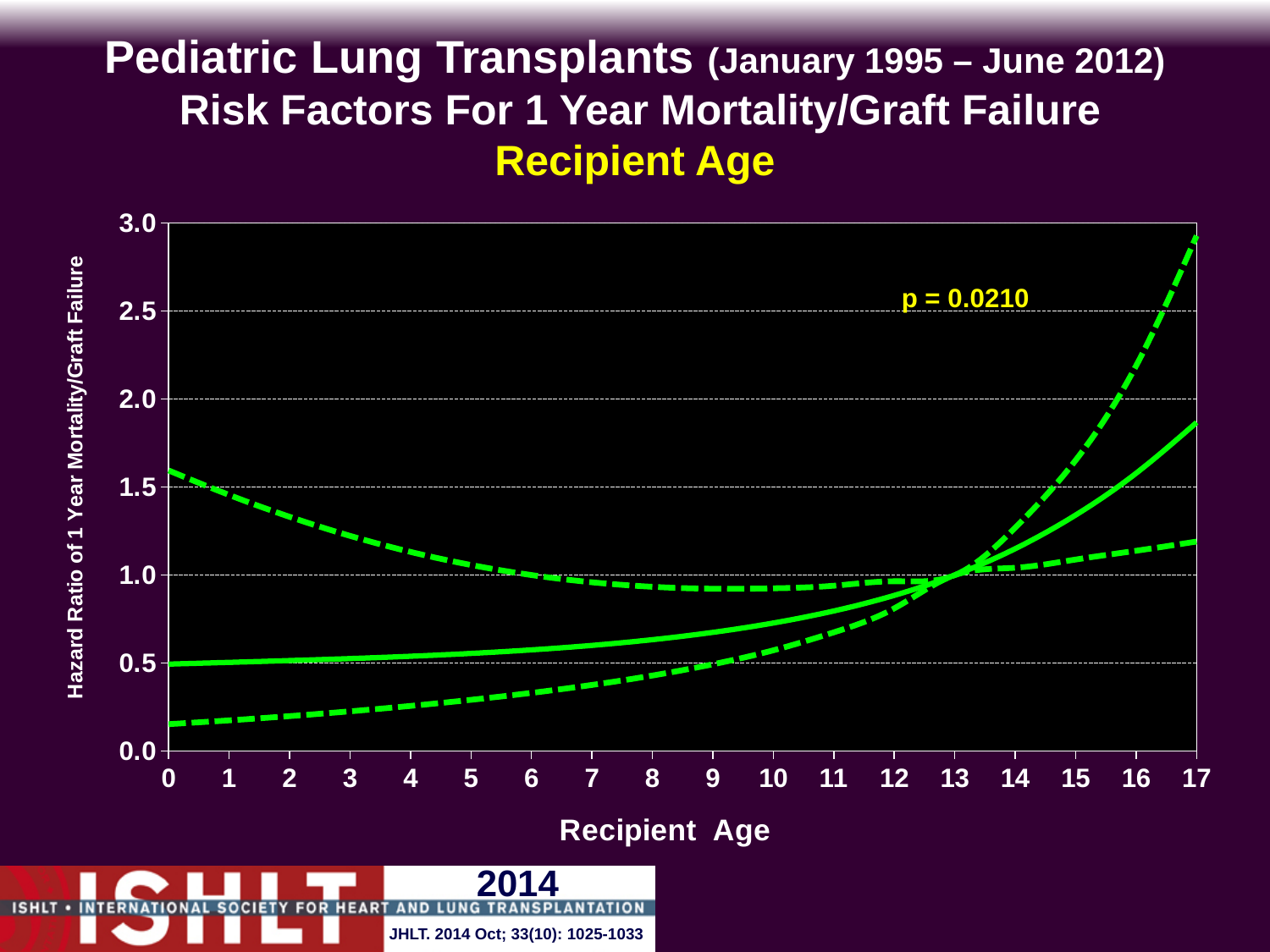
Is the value of the solid line at recipient age 5 greater or less than 1.0? less Does the solid line rise or fall as recipient age increases from 0 to 17? rises Is the value of the upper dashed line at recipient age 0 greater or less than 1.0? greater What p-value is printed on the chart? p = 0.0210 Is the value of the upper dashed line at recipient age 17 greater or less than 2.5? greater What kind of chart is shown on the slide? line chart What is the highest value shown on the y axis? 3.0 How many lines are plotted on the chart? 3 Is the solid line higher at recipient age 17 or at recipient age 0? age 17